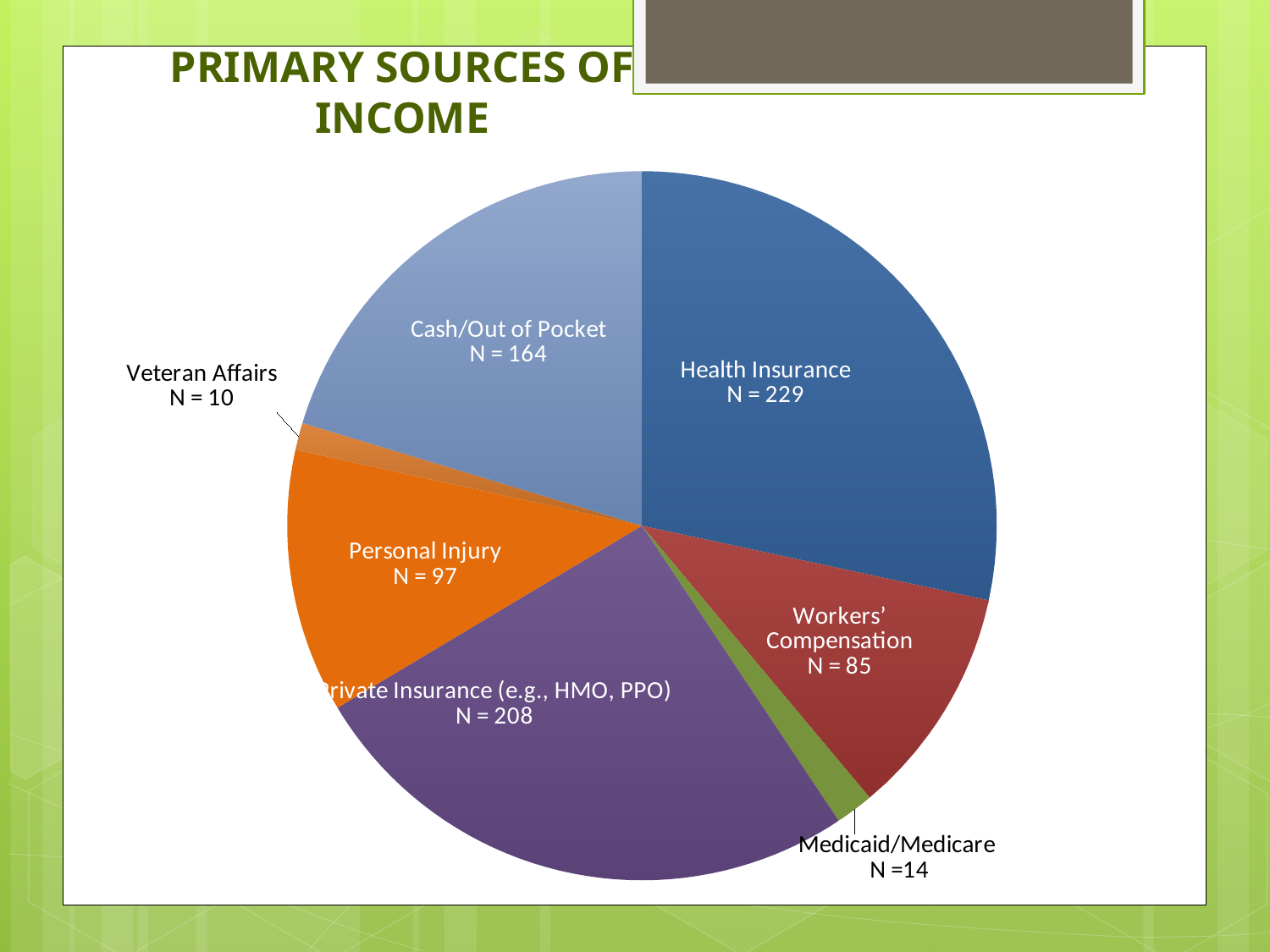
What is the N value for Veteran Affairs? 10 Which source of income has the largest slice of the pie? Health Insurance What is the N value for Health Insurance? 229 What is the total N across all slices of the pie chart? 807 What kind of chart is shown on the slide? Pie chart What is the N value for Medicaid/Medicare? 14 What is the difference between the N values for Cash/Out of Pocket and Personal Injury? 67 What is the difference between the N values for Health Insurance and Private Insurance (e.g., HMO, PPO)? 21 Which source of income has the smallest slice of the pie? Veteran Affairs What is the title of the chart on the slide? PRIMARY SOURCES OF INCOME How many slices does the pie chart have? 7 Which has a larger N value, Personal Injury or Workers' Compensation? Personal Injury